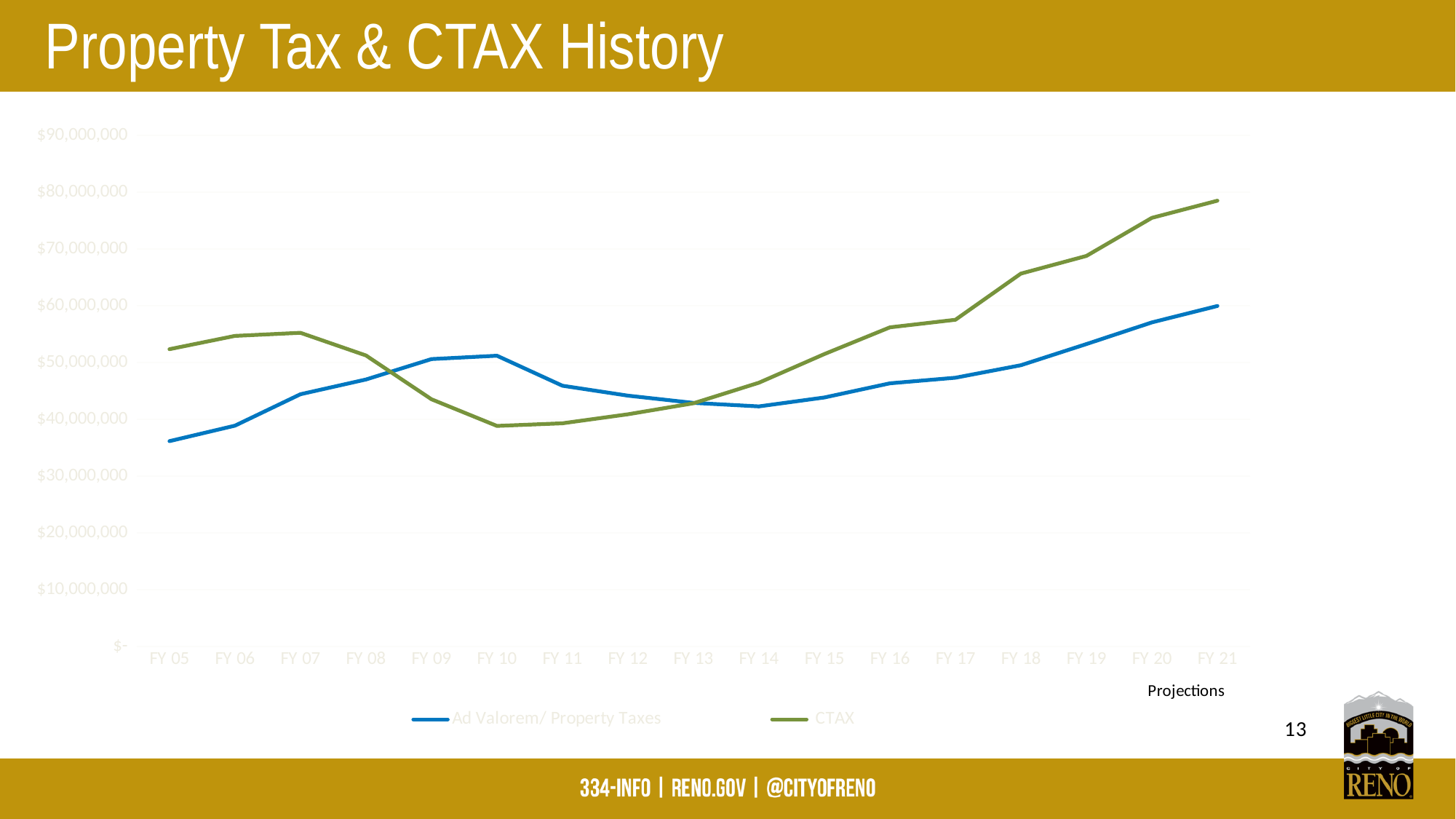
How many series does the legend list? 2 What kind of chart is shown on the slide? line chart What label appears below the x axis near FY 21? Projections Is the value for CTAX in FY 18 greater or less than $60,000,000? greater In FY 10, which series has the larger value, Ad Valorem/Property Taxes or CTAX? Ad Valorem/Property Taxes How many fiscal years are plotted along the x axis? 17 In which fiscal year is the Ad Valorem/Property Taxes line at its lowest? FY 05 Does the CTAX line rise or fall from FY 10 to FY 21? rise In which fiscal year does the CTAX line reach its highest value? FY 21 Is the value for Ad Valorem/Property Taxes in FY 05 greater or less than $40,000,000? less In FY 21, which series has the larger value, Ad Valorem/Property Taxes or CTAX? CTAX Is the value for CTAX in FY 21 greater or less than $70,000,000? greater